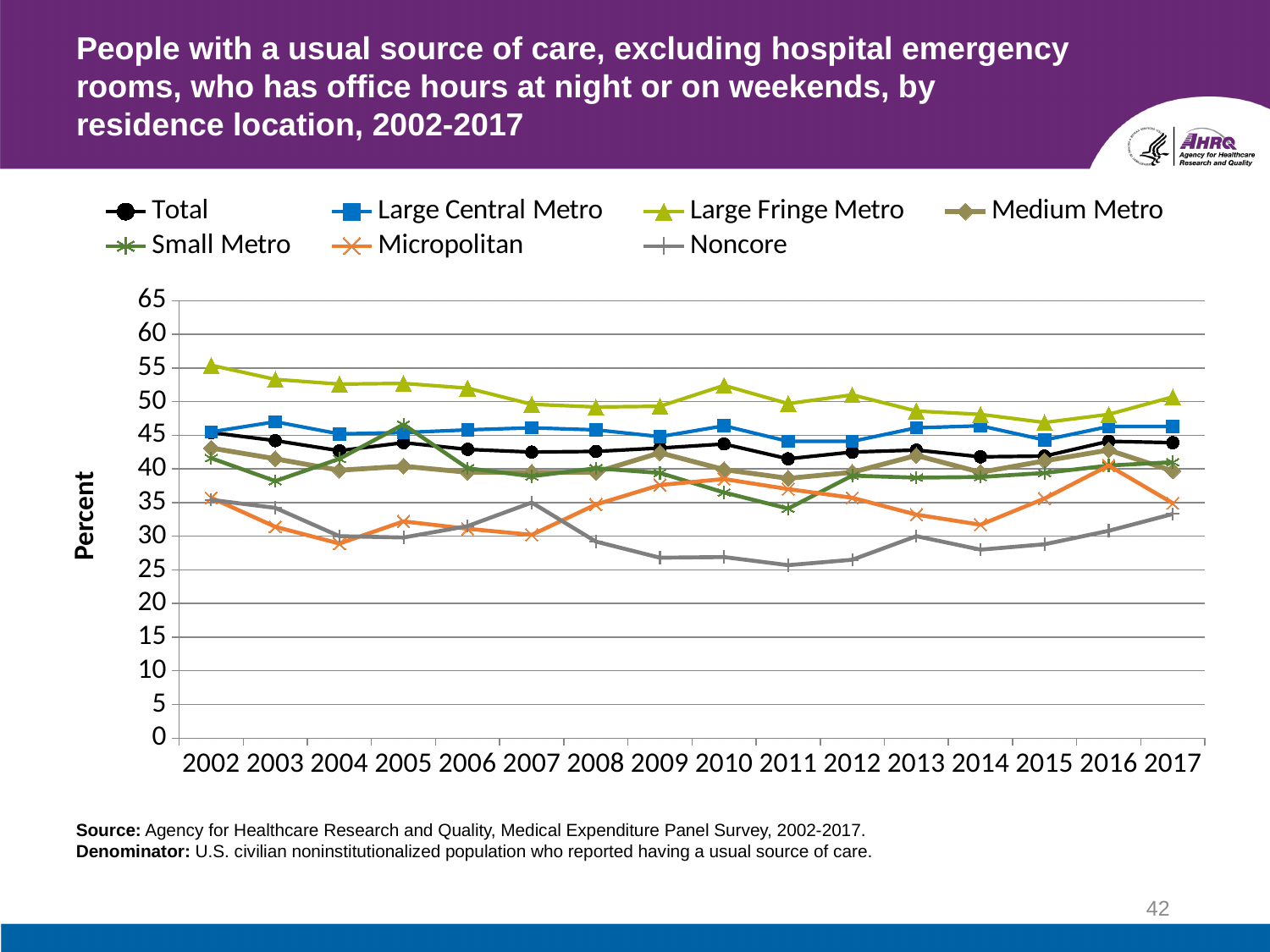
Is the value for Large Central Metro in 2002 greater or less than 40? greater Is the value for Large Fringe Metro in 2002 greater or less than 50? greater How many years are shown along the x axis? 16 What kind of chart is shown on the slide? line chart Is the value for Micropolitan in 2004 greater or less than 30? less Which residence location has the highest value in 2002? Large Fringe Metro Does the Large Fringe Metro line rise or fall from 2002 to 2007? fall What is the label on the y axis? Percent How many series does the legend list? 7 Which residence location has the lowest value in 2011? Noncore In 2010, which is larger: the value for Large Fringe Metro or the value for Noncore? Large Fringe Metro